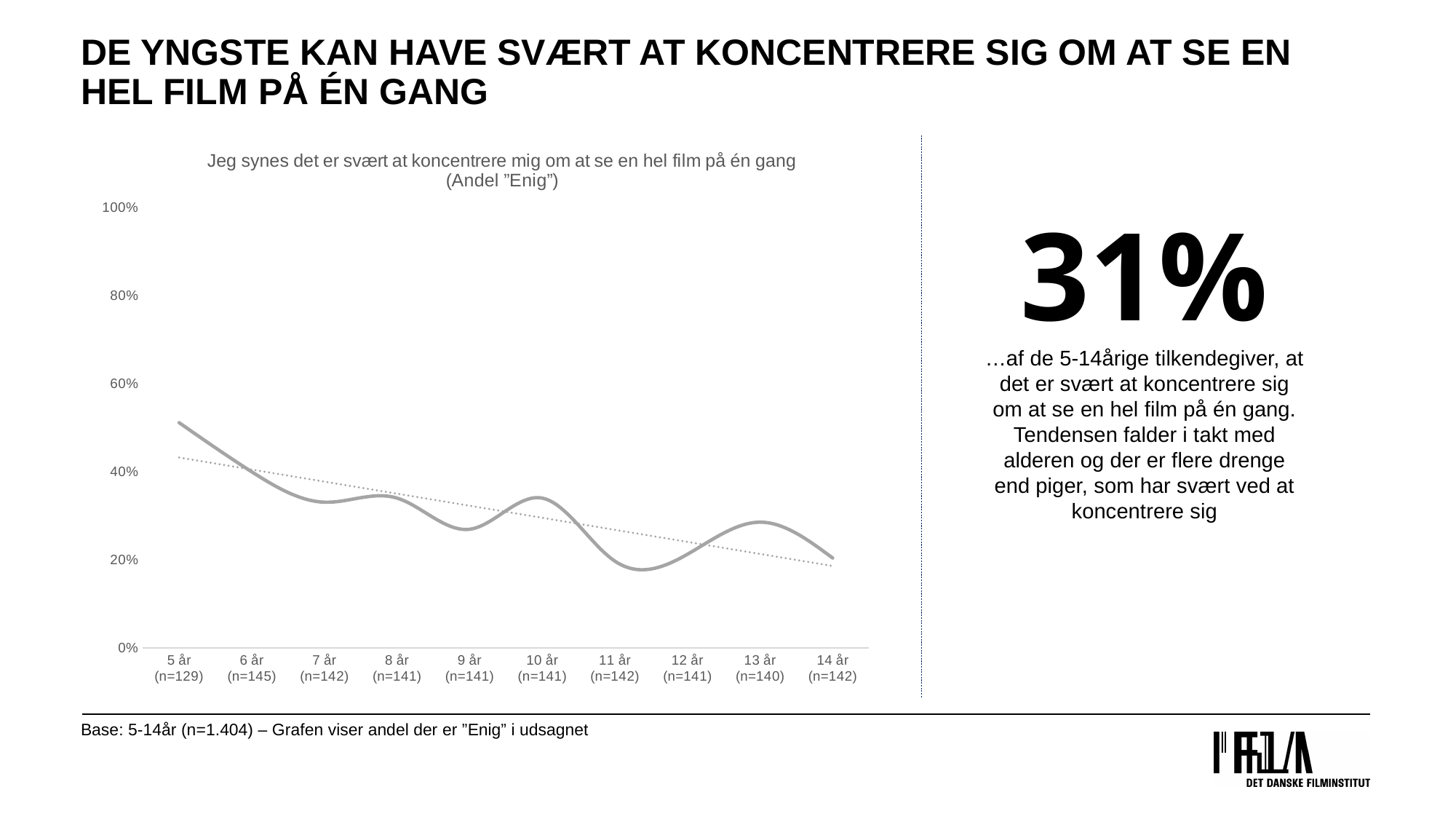
Which has the larger value in the chart, 6 år or 11 år? 6 år What is the title of the chart? Jeg synes det er svært at koncentrere mig om at se en hel film på én gang (Andel "Enig") Is the value for 9 år greater or less than 40%? less What kind of chart is shown on the slide? line chart Is the value for 5 år greater or less than 40%? greater Which age group has the highest share of "Enig" in the chart? 5 år What is the sample size (n) shown for the 5 år category on the x axis? n=129 Which has the larger value in the chart, 5 år or 14 år? 5 år Is the value for 11 år greater or less than 40%? less How many age groups are plotted along the x axis of the chart? 10 Do the values in the chart generally rise or fall as age increases from 5 år to 14 år? fall